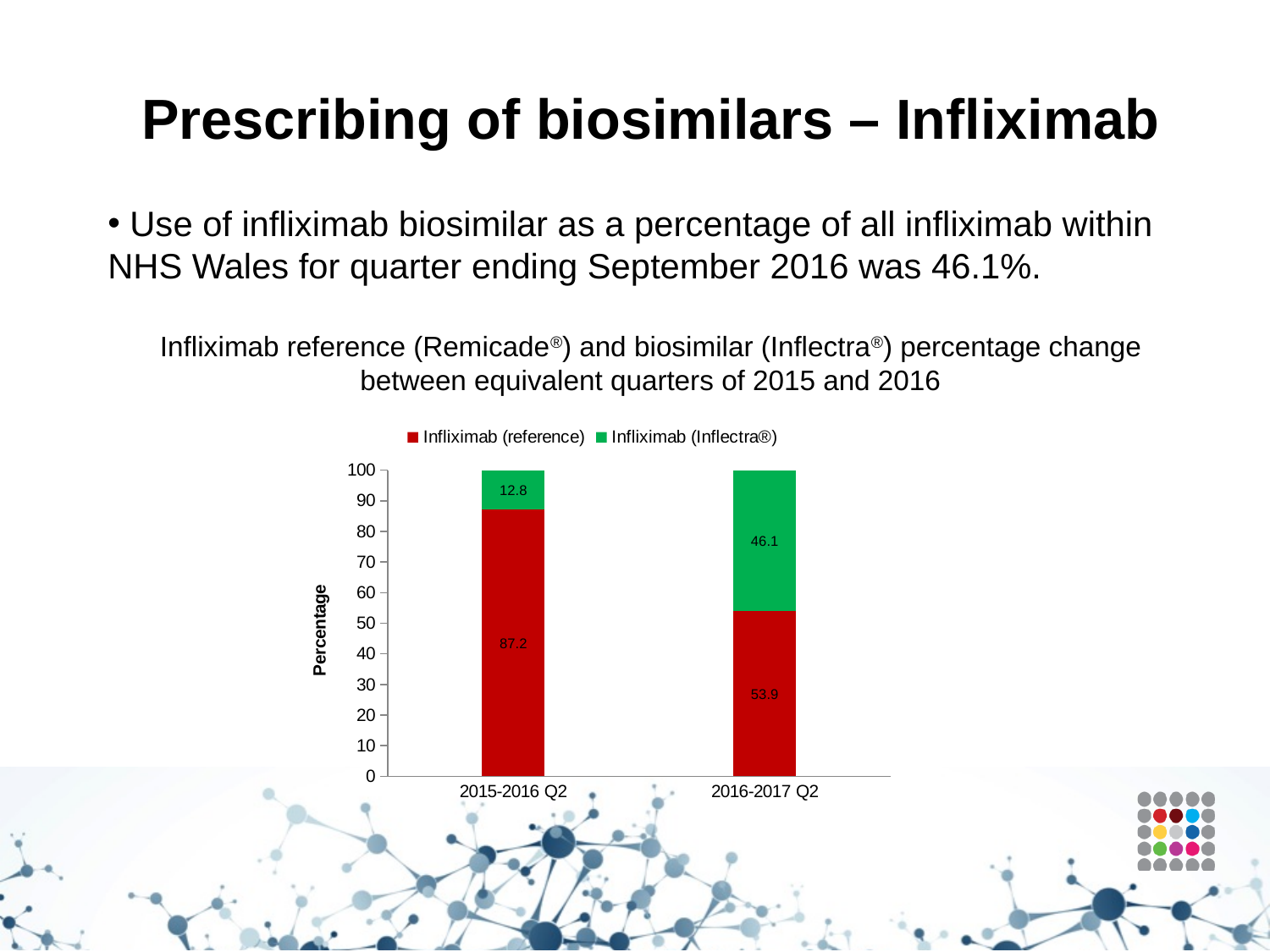
In which quarter is the Infliximab (Inflectra®) value highest? 2016-2017 Q2 What is the total of the stacked bar for 2015-2016 Q2? 100 What kind of chart is shown on the slide? Stacked bar chart How many quarters are shown on the x axis? 2 What is the value for Infliximab (Inflectra®) in 2015-2016 Q2? 12.8 Which is larger in 2016-2017 Q2: Infliximab (reference) or Infliximab (Inflectra®)? Infliximab (reference) What is the difference between the Infliximab (reference) values for 2015-2016 Q2 and 2016-2017 Q2? 33.3 What is the value for Infliximab (reference) in 2015-2016 Q2? 87.2 In which quarter is the Infliximab (reference) value lowest? 2016-2017 Q2 What is the value for Infliximab (reference) in 2016-2017 Q2? 53.9 What is the value for Infliximab (Inflectra®) in 2016-2017 Q2? 46.1 How many series does the legend list? 2